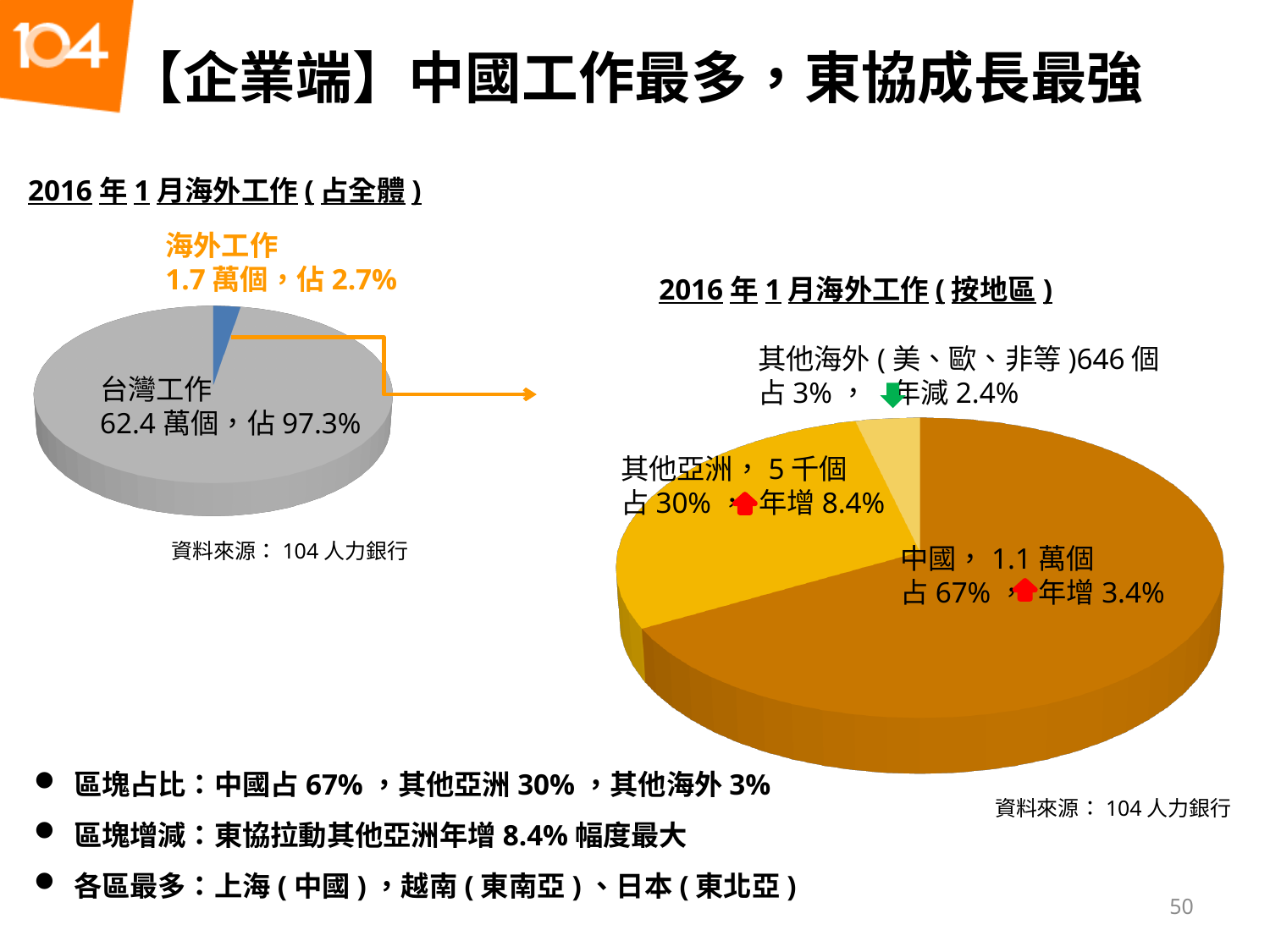
In the chart titled 2016年1月海外工作(按地區), how many jobs does the 其他海外(美、歐、非等) slice represent? 646 個 In the chart titled 2016年1月海外工作(占全體), what share of the pie does 台灣工作 account for? 97.3% In the chart titled 2016年1月海外工作(占全體), how many jobs does the 海外工作 slice represent? 1.7 萬個 In the chart titled 2016年1月海外工作(按地區), what share of the pie does 中國 account for? 67% In the chart titled 2016年1月海外工作(按地區), what is the year-on-year change shown for 其他亞洲? 年增 8.4% What type of chart is the chart titled 2016年1月海外工作(按地區)? Pie chart In the chart titled 2016年1月海外工作(占全體), how many slices does the pie have? 2 In the chart titled 2016年1月海外工作(占全體), what share of the pie does 海外工作 account for? 2.7% In the chart titled 2016年1月海外工作(按地區), what is the difference in percentage points between the shares of 中國 and 其他亞洲? 37 percentage points In the chart titled 2016年1月海外工作(按地區), how many slices does the pie have? 3 In the chart titled 2016年1月海外工作(按地區), which region has the smallest slice? 其他海外(美、歐、非等) In the chart titled 2016年1月海外工作(按地區), which region has the largest slice? 中國